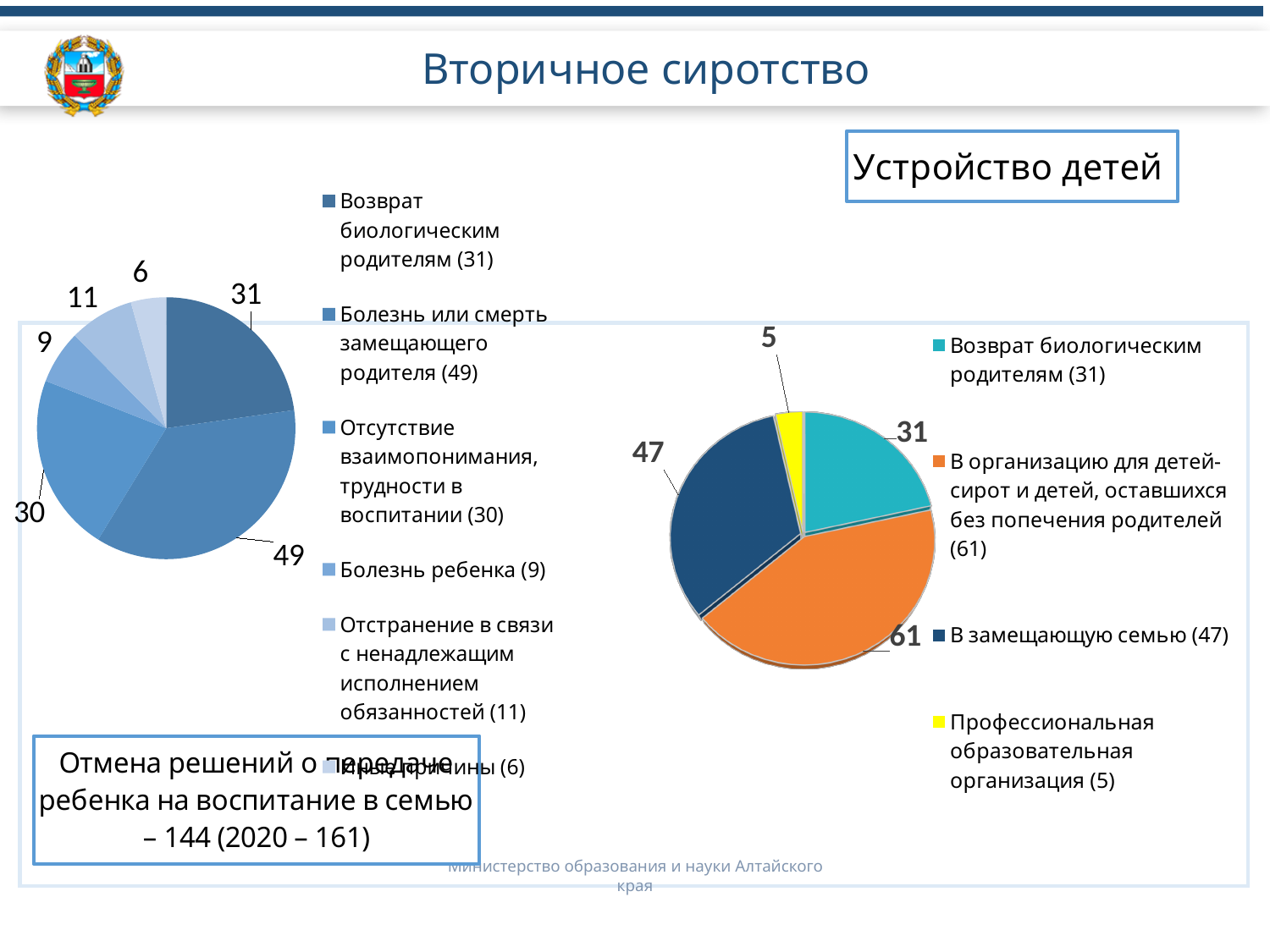
On the «Устройство детей» chart, which is larger: «Возврат биологическим родителям» or «В замещающую семью»? В замещающую семью On the «Устройство детей» chart, which category has the largest value? В организацию для детей-сирот и детей, оставшихся без попечения родителей On the «Устройство детей» chart, what is the difference between «В организацию для детей-сирот» and «Профессиональная образовательная организация»? 56 On the «Устройство детей» chart, which colour represents «Профессиональная образовательная организация»? Yellow On the «Устройство детей» chart, what is the value for «В замещающую семью»? 47 How many categories does the left pie chart show? 6 On the left pie chart, which category has the largest value? Болезнь или смерть замещающего родителя What type of chart is the «Устройство детей» chart? Pie chart On the left pie chart, what is the difference between «Возврат биологическим родителям» and «Болезнь ребенка»? 22 On the left pie chart, what is the value for «Отстранение в связи с ненадлежащим исполнением обязанностей»? 11 On the left pie chart, which category has the smallest value? Иные причины On the left pie chart, what is the value for «Болезнь или смерть замещающего родителя»? 49